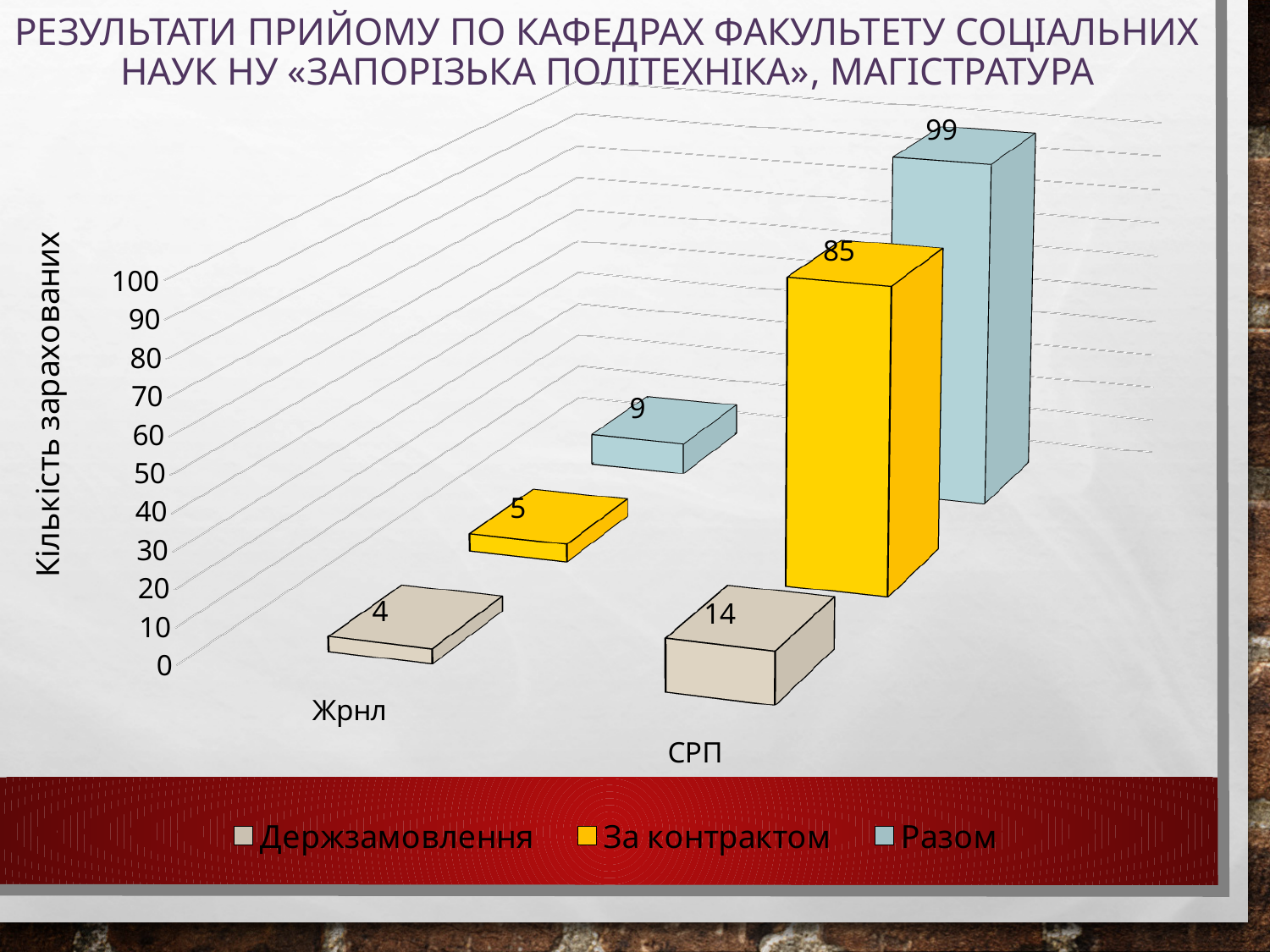
How many categories are shown on the x axis? 2 What kind of chart is shown on the slide? Bar chart What is the value of Разом for СРП? 99 What is the label of the vertical axis? Кількість зарахованих What is the value of Держзамовлення for Жрнл? 4 Which category has the highest value for Разом? СРП What is the value of Разом for Жрнл? 9 What is the value of За контрактом for СРП? 85 What is the difference between the Разом values for СРП and Жрнл? 90 Which is larger: За контрактом for СРП or Держзамовлення for СРП? За контрактом for СРП How many series does the legend list? 3 Which category has the lowest value for Держзамовлення? Жрнл